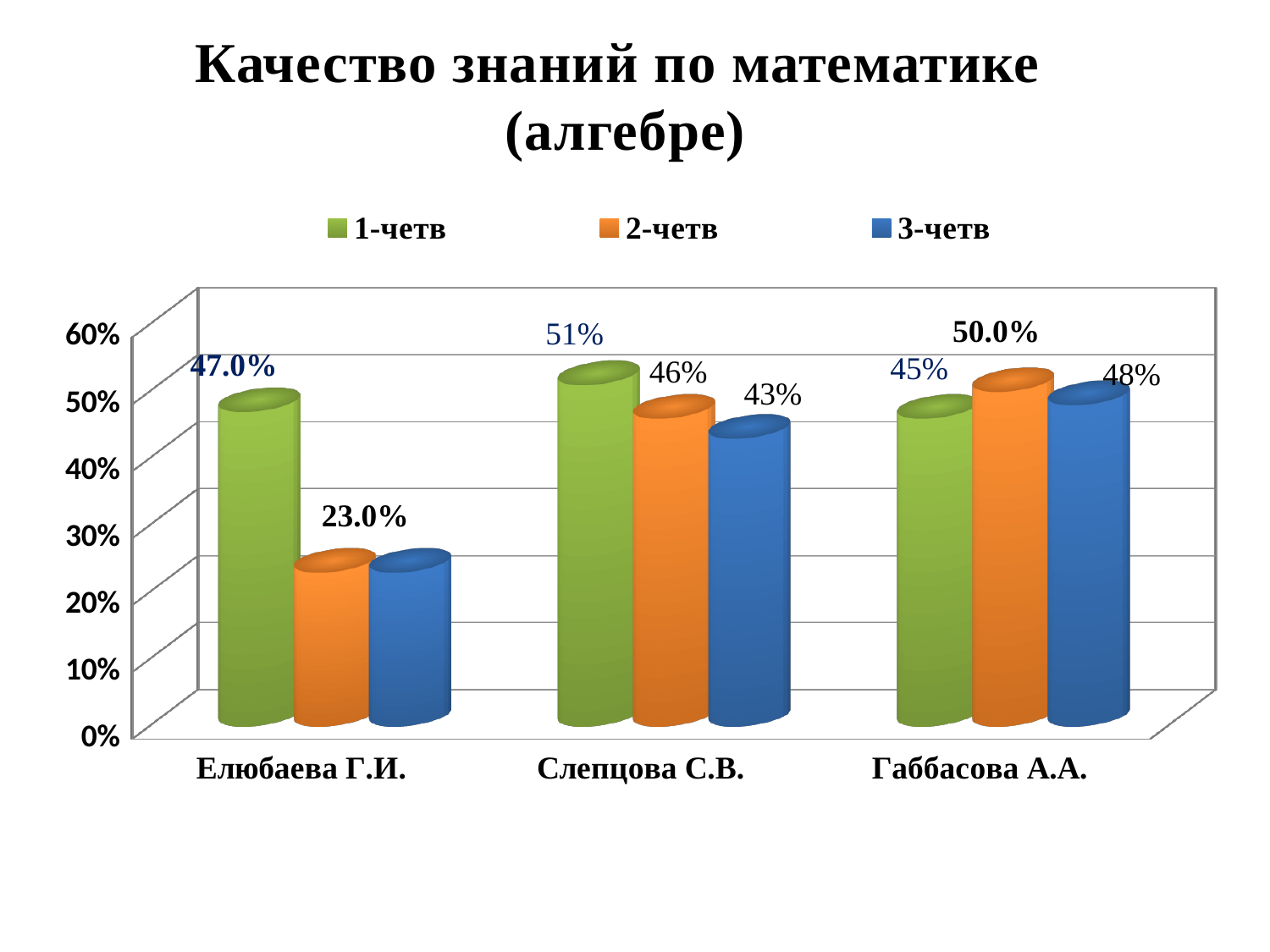
What is the value for Елюбаева Г.И. in the 2-четв series? 23.0% How many teachers are shown on the x axis? 3 How many series does the legend list? 3 What is the value for Слепцова С.В. in the 3-четв series? 43% What is the value for Габбасова А.А. in the 2-четв series? 50.0% Which teacher has the lowest value in the 2-четв series? Елюбаева Г.И. What is the difference between the 1-четв and 2-четв values for Елюбаева Г.И.? 24.0% Is the value for Елюбаева Г.И. in the 3-четв series greater or less than 30%? less What is the value for Елюбаева Г.И. in the 1-четв series? 47.0% Which is larger for Габбасова А.А.: the 1-четв value or the 3-четв value? 3-четв What kind of chart is shown on the slide? bar chart Which teacher has the highest value in the 1-четв series? Слепцова С.В.